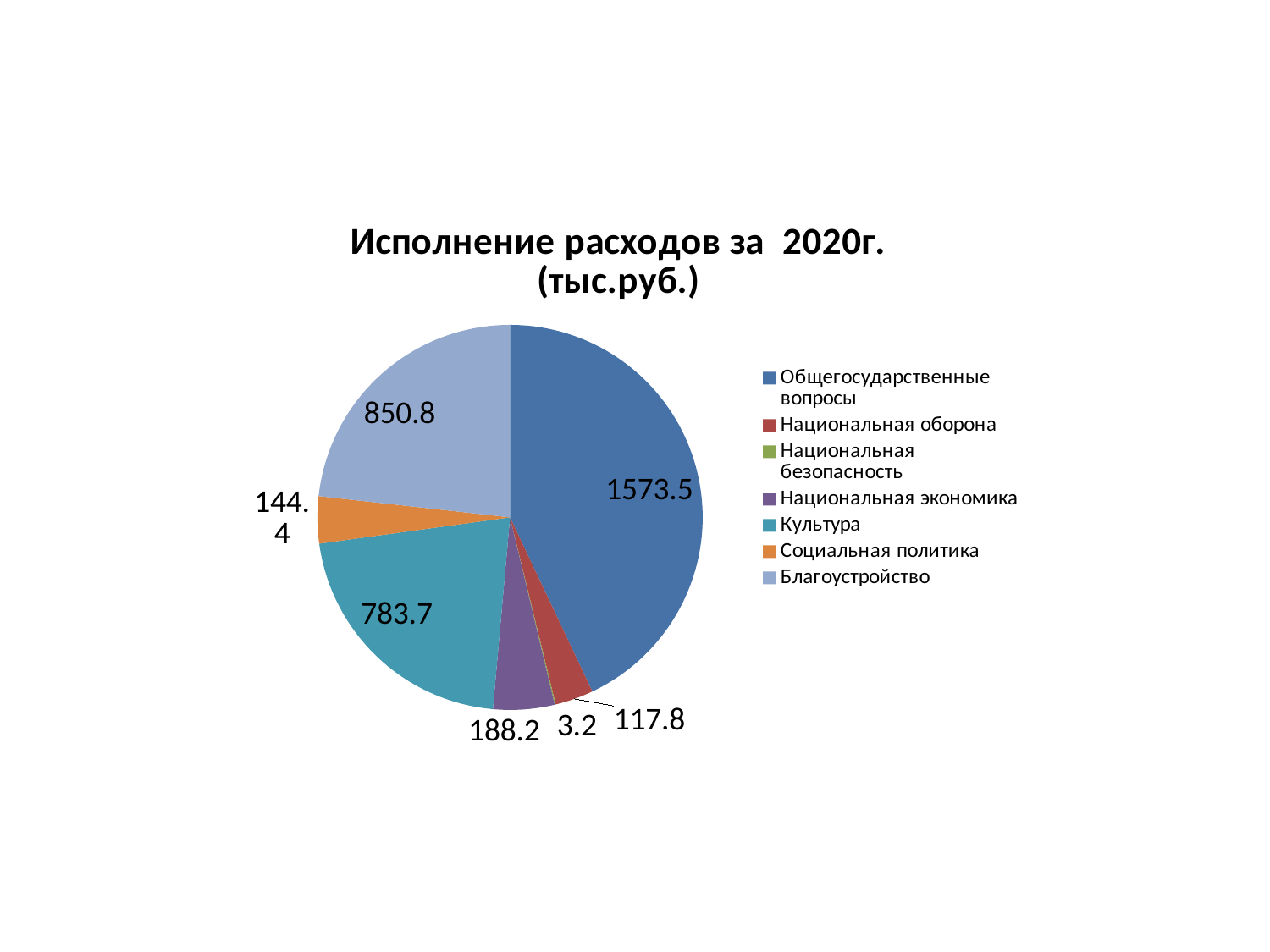
What is the value for Культура? 783.7 How many categories does the pie chart show? 7 Which category has the smallest slice? Национальная безопасность Which is larger, Благоустройство or Культура? Благоустройство What is the value for Общегосударственные вопросы? 1573.5 What is the title of the chart? Исполнение расходов за 2020г. (тыс.руб.) What type of chart is shown on the slide? Pie chart What is the value for Социальная политика? 144.4 What is the difference between Общегосударственные вопросы and Благоустройство? 722.7 What is the value for Национальная безопасность? 3.2 What is the difference between Национальная экономика and Социальная политика? 43.8 Which category has the largest slice? Общегосударственные вопросы